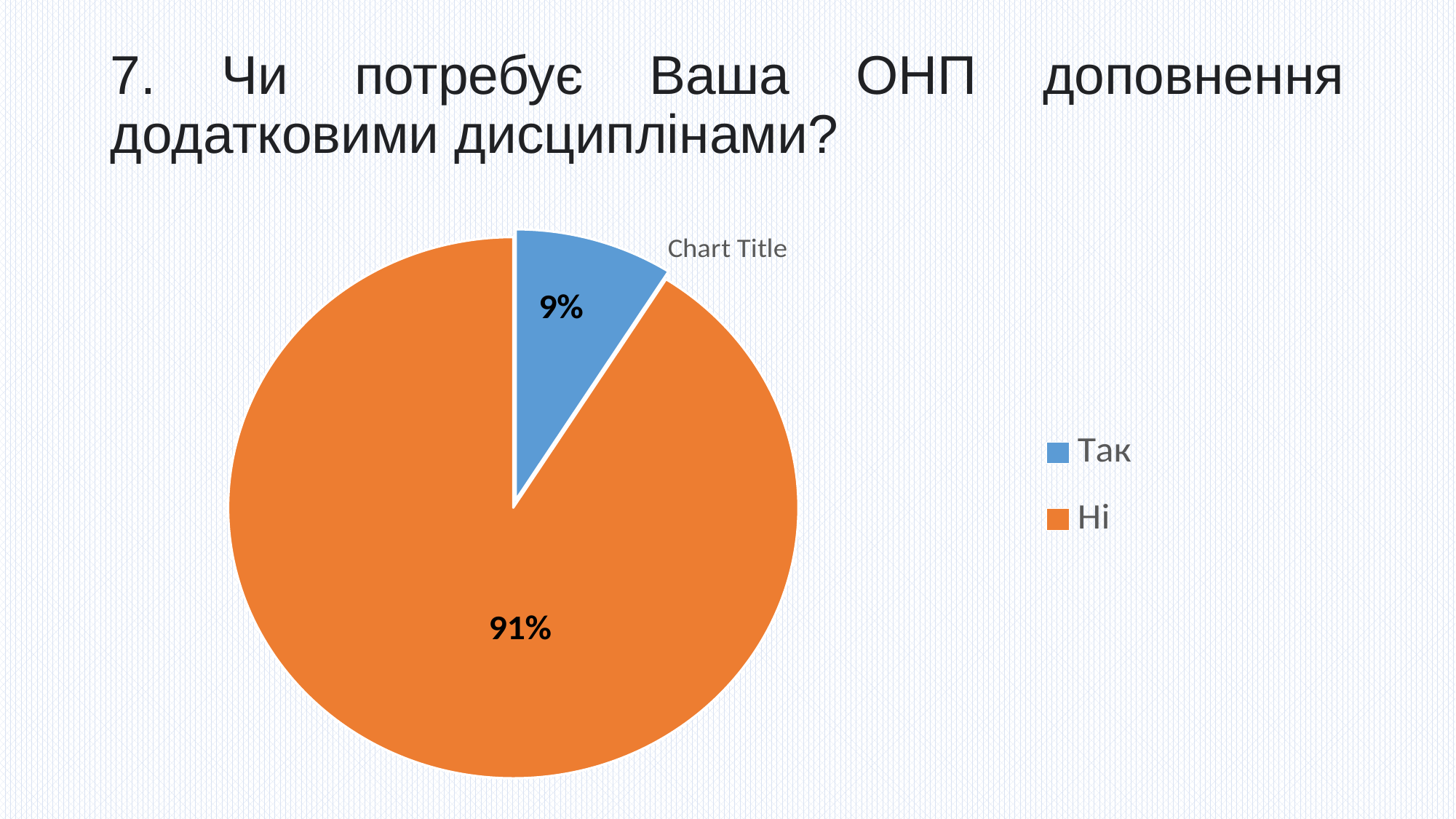
What colour is the "Ні" slice? orange Which is larger, the "Так" slice or the "Ні" slice? Ні Which category has the smallest slice of the pie? Так What kind of chart is shown on the slide? pie chart Which category has the largest slice of the pie? Ні What share of the pie does "Так" represent? 9% How many entries does the legend list? 2 How many categories does the pie chart have? 2 What share of the pie does "Ні" represent? 91% What is the difference in percentage points between the "Ні" and "Так" slices? 82 What is the title shown on the chart? Chart Title